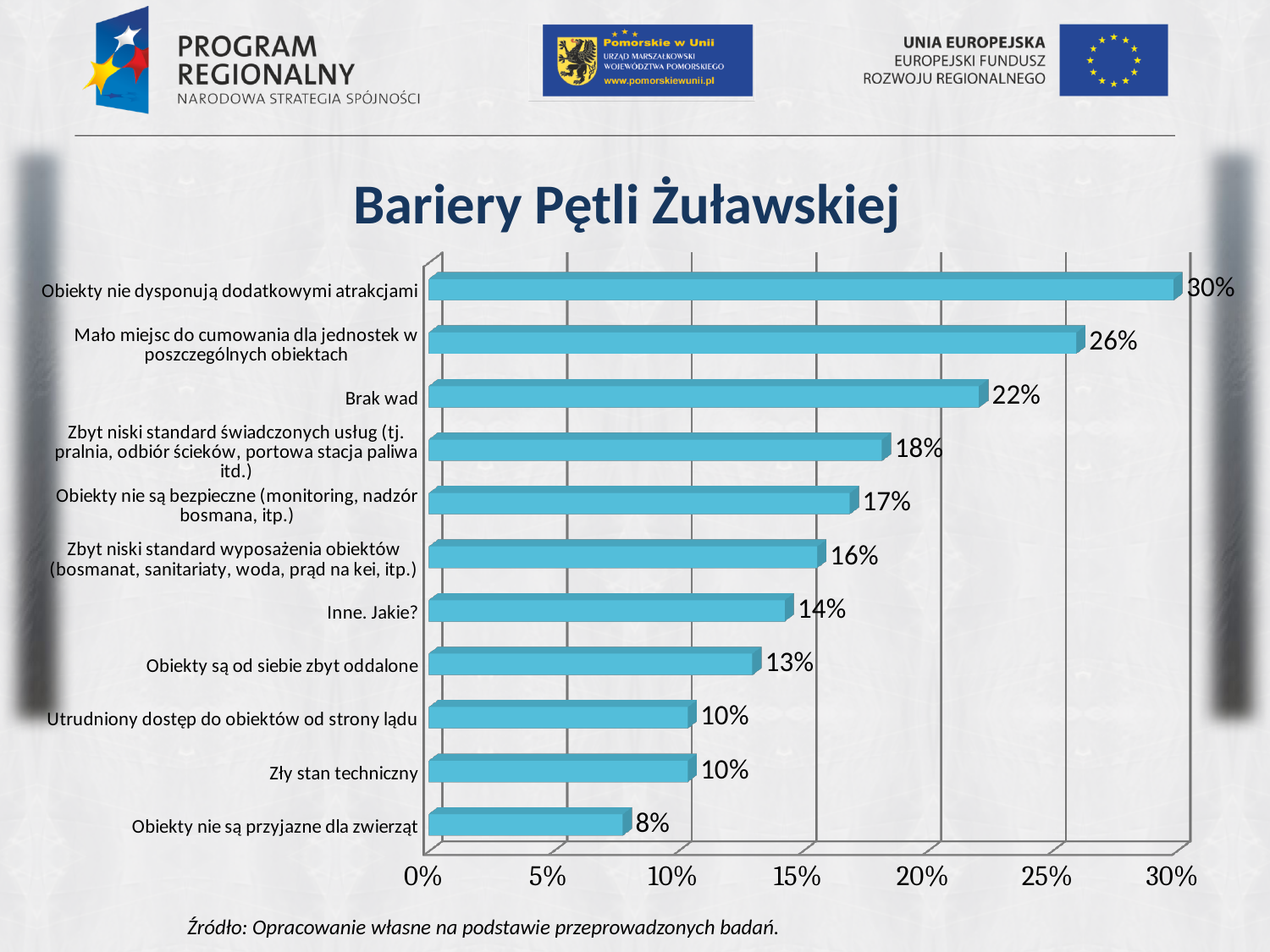
Which category has the highest value? Obiekty nie dysponują dodatkowymi atrakcjami What is the title of the chart? Bariery Pętli Żuławskiej Which is larger: the value for "Zły stan techniczny" or the value for "Obiekty nie są przyjazne dla zwierząt"? Zły stan techniczny Which category has the lowest value? Obiekty nie są przyjazne dla zwierząt What is the value for "Obiekty są od siebie zbyt oddalone"? 13% What is the value for "Utrudniony dostęp do obiektów od strony lądu"? 10% Is the value for "Mało miejsc do cumowania dla jednostek w poszczególnych obiektach" greater or less than 25%? greater What is the difference between the values for "Obiekty nie dysponują dodatkowymi atrakcjami" and "Brak wad"? 8% What is the value for "Brak wad"? 22% What is the value for "Inne. Jakie?"? 14% What kind of chart is shown on the slide? bar chart How many categories are shown in the chart? 11